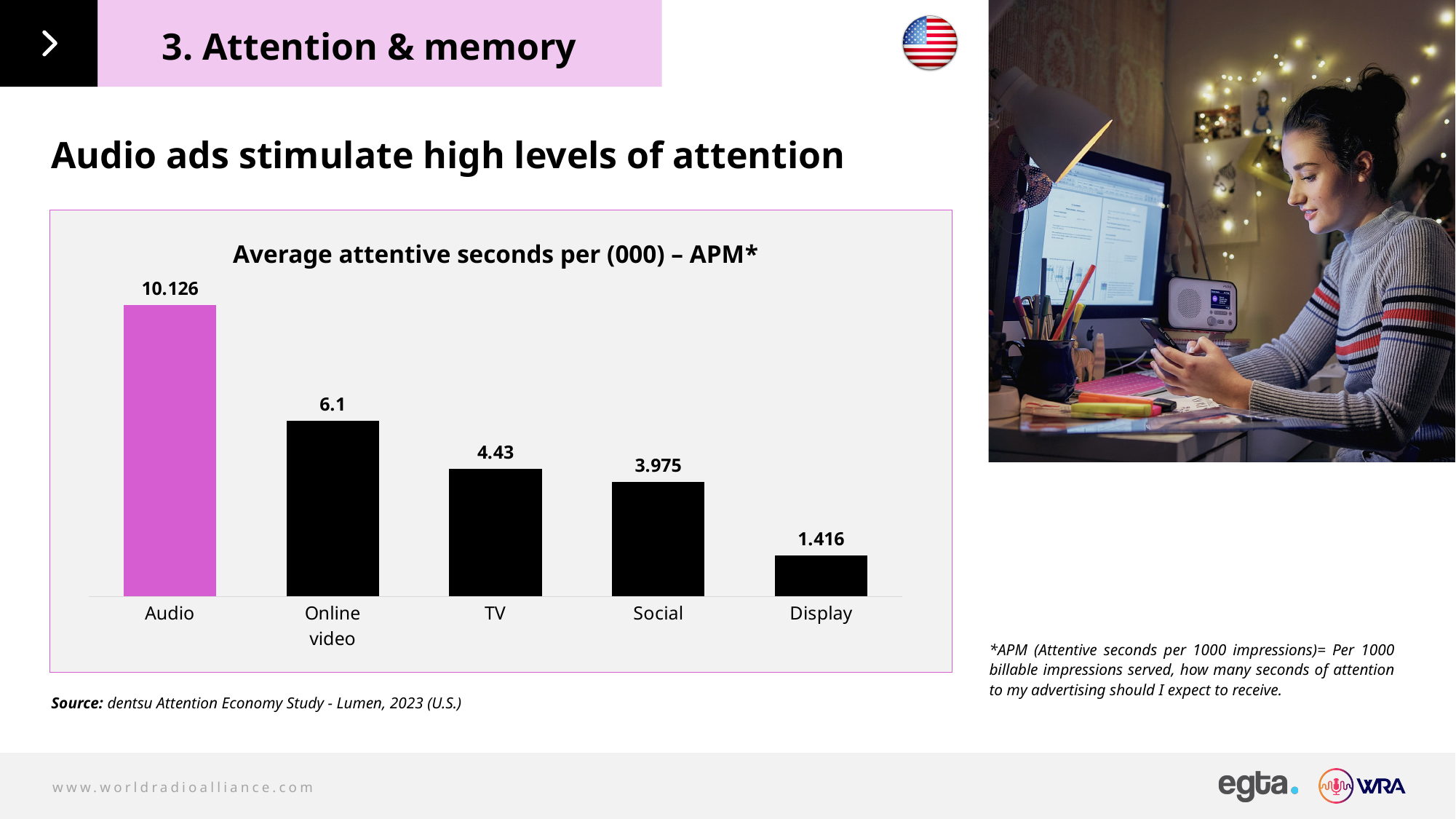
How many categories are shown in the chart? 5 What kind of chart is shown on the slide? Bar chart What is the difference between the values for Audio and Online video? 4.026 Which category has the lowest value? Display Which is larger, the value for Social or the value for Display? Social What is the value for Display? 1.416 What is the title of the chart? Average attentive seconds per (000) – APM* What is the value for Audio in the chart? 10.126 Which category has the highest value? Audio What is the difference between the values for TV and Social? 0.455 What is the value for TV? 4.43 What is the value for Online video? 6.1